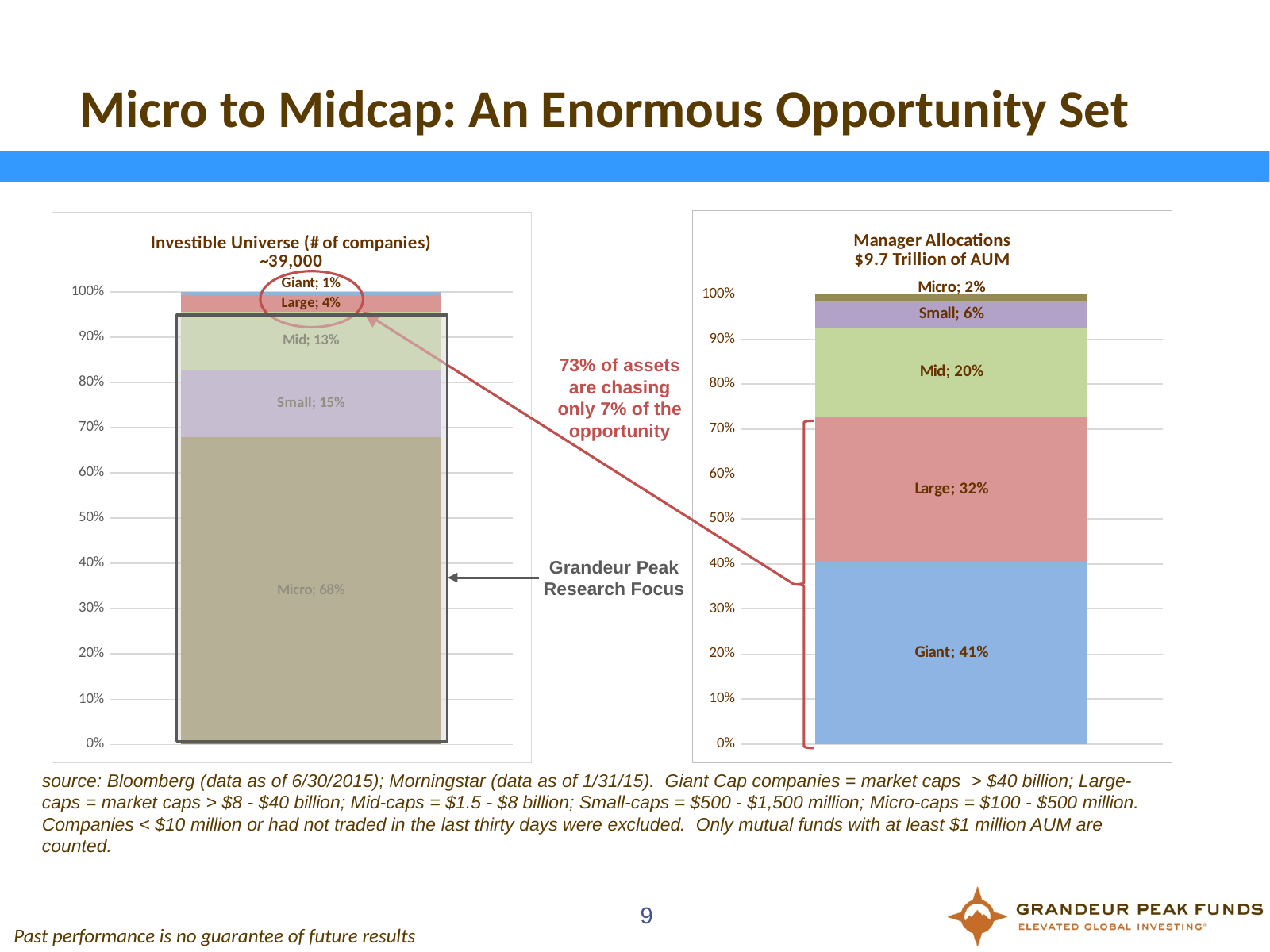
In the Investible Universe chart, what percentage is labelled for Micro? 68% In the Manager Allocations chart, what is the difference between the Large and Mid percentages? 12% In the Investible Universe chart, which segment has the smallest share? Giant In the Manager Allocations chart, what is the combined percentage of Giant and Large? 73% In the Manager Allocations chart, which segment has the largest share? Giant In the Manager Allocations chart, what percentage is labelled for Small? 6% In the Investible Universe chart, which is larger, Small or Mid? Small How many segments make up the bar in the Manager Allocations chart? 5 In the Investible Universe chart, what percentage is labelled for Mid? 13% What kind of chart is the Investible Universe chart? Stacked bar chart What total AUM is stated in the title of the Manager Allocations chart? $9.7 Trillion In the Manager Allocations chart, what percentage is labelled for Giant? 41%